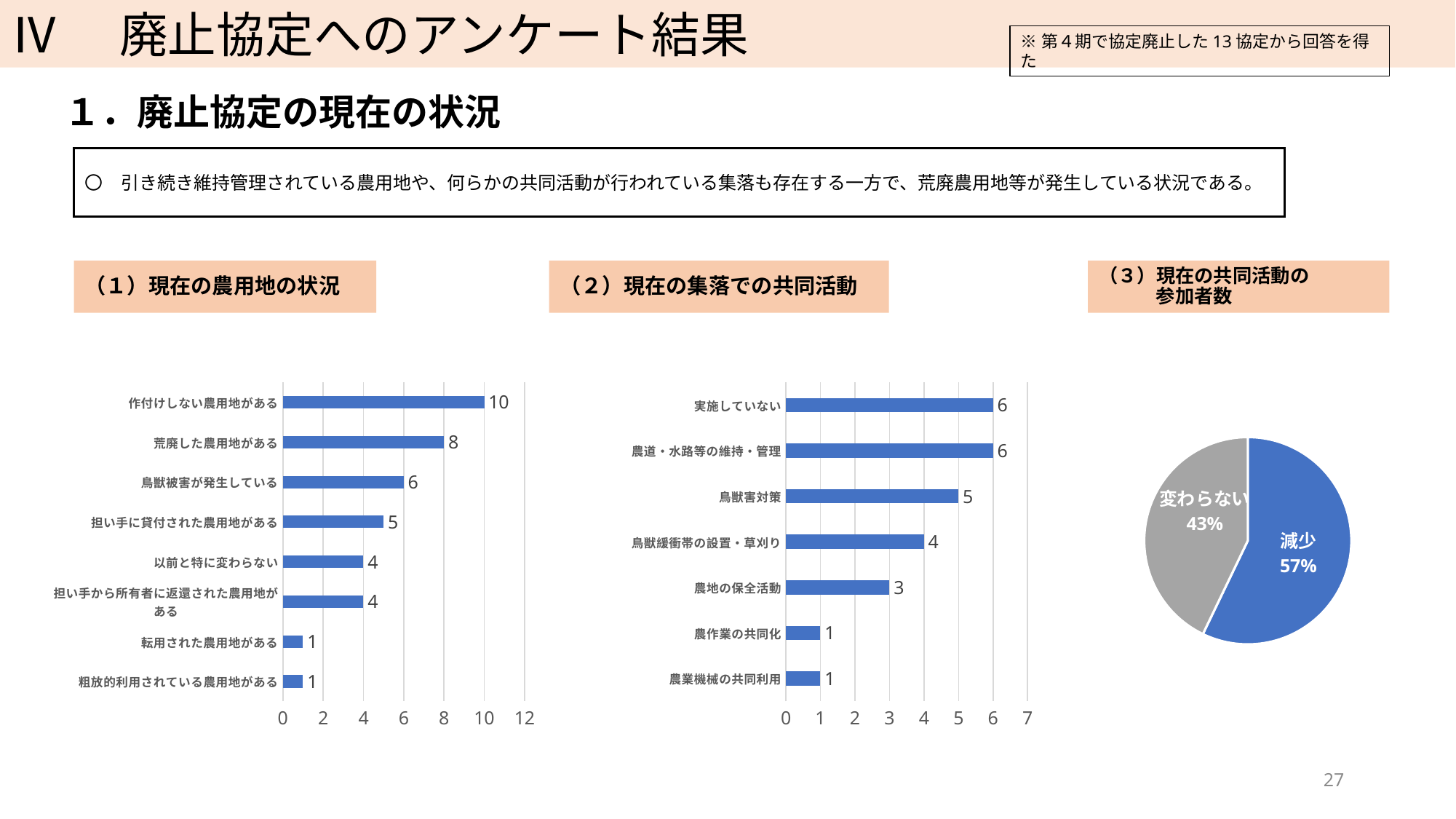
In the chart (3) 現在の共同活動の参加者数, what kind of chart is it? pie chart In the chart (1) 現在の農用地の状況, what is the value for 作付けしない農用地がある? 10 In the chart (2) 現在の集落での共同活動, how many categories are shown? 7 In the chart (3) 現在の共同活動の参加者数, which slice is larger, 減少 or 変わらない? 減少 In the chart (1) 現在の農用地の状況, which category has the highest value? 作付けしない農用地がある In the chart (1) 現在の農用地の状況, how many categories are shown? 8 In the chart (1) 現在の農用地の状況, what kind of chart is it? bar chart In the chart (2) 現在の集落での共同活動, what is the value for 鳥獣害対策? 5 In the chart (3) 現在の共同活動の参加者数, what share does 減少 have? 57% In the chart (2) 現在の集落での共同活動, which is larger, 鳥獣緩衝帯の設置・草刈り or 農地の保全活動? 鳥獣緩衝帯の設置・草刈り In the chart (2) 現在の集落での共同活動, what is the value for 農業機械の共同利用? 1 In the chart (1) 現在の農用地の状況, what is the difference between 荒廃した農用地がある and 鳥獣被害が発生している? 2